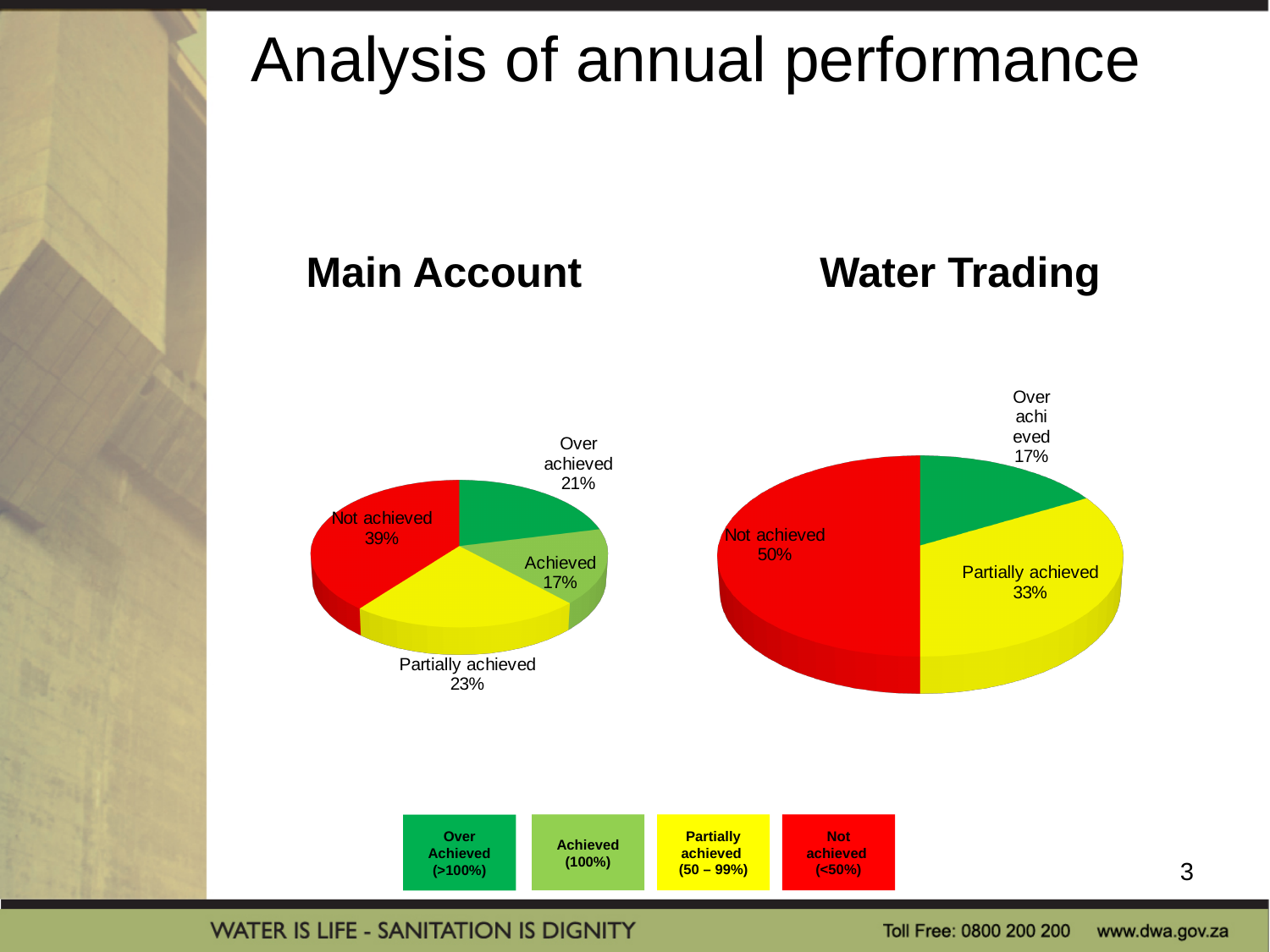
How many slices does the Water Trading chart have? 3 In the Main Account chart, what percentage is labelled Over achieved? 21% In the Water Trading chart, what percentage is labelled Not achieved? 50% In the Water Trading chart, what is the difference between the Not achieved and Over achieved shares? 33% In the Water Trading chart, what percentage is labelled Partially achieved? 33% In the Main Account chart, which category has the largest share? Not achieved Which chart has the larger Not achieved share, Main Account or Water Trading? Water Trading In the Main Account chart, which category has the smallest share? Achieved In the Main Account chart, what is the difference between the Not achieved and Partially achieved shares? 16% What type of chart is the Main Account chart? Pie chart In the Main Account chart, what percentage is labelled Not achieved? 39% In the Water Trading chart, which category has the smallest share? Over achieved